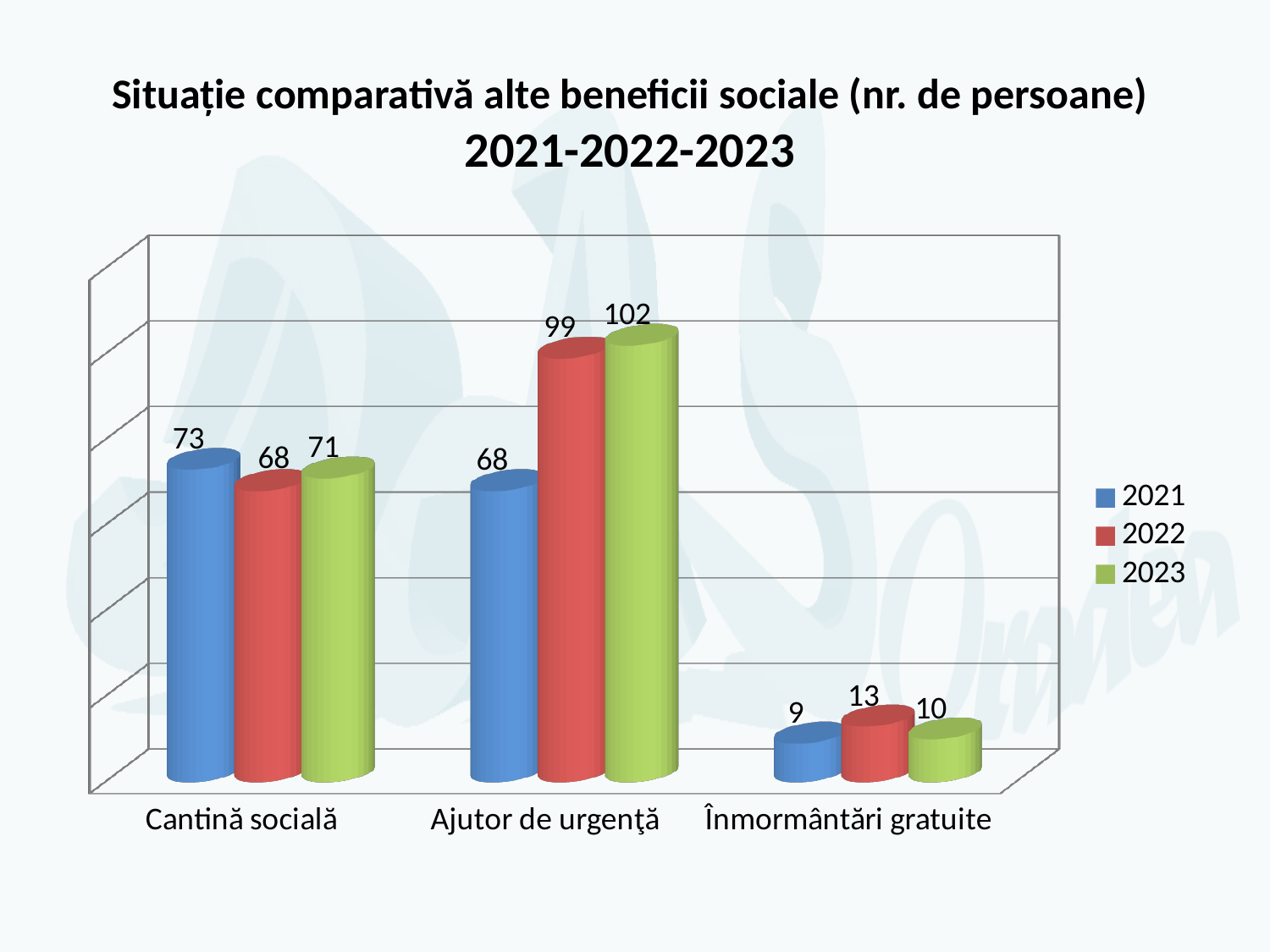
Which category has the highest value in 2022? Ajutor de urgenţă What is the value for Cantină socială in 2021? 73 What is the difference between the 2023 and 2021 values for Ajutor de urgenţă? 34 How many categories are shown on the x axis? 3 Which category has the lowest value in 2023? Înmormântări gratuite Which is larger for Cantină socială: the 2021 value or the 2023 value? 2021 What kind of chart is shown on the slide? Bar chart What is the difference between the 2021 and 2022 values for Cantină socială? 5 What is the value for Înmormântări gratuite in 2022? 13 How many series does the legend list? 3 Which year does the green series represent in the legend? 2023 What is the value for Ajutor de urgenţă in 2023? 102